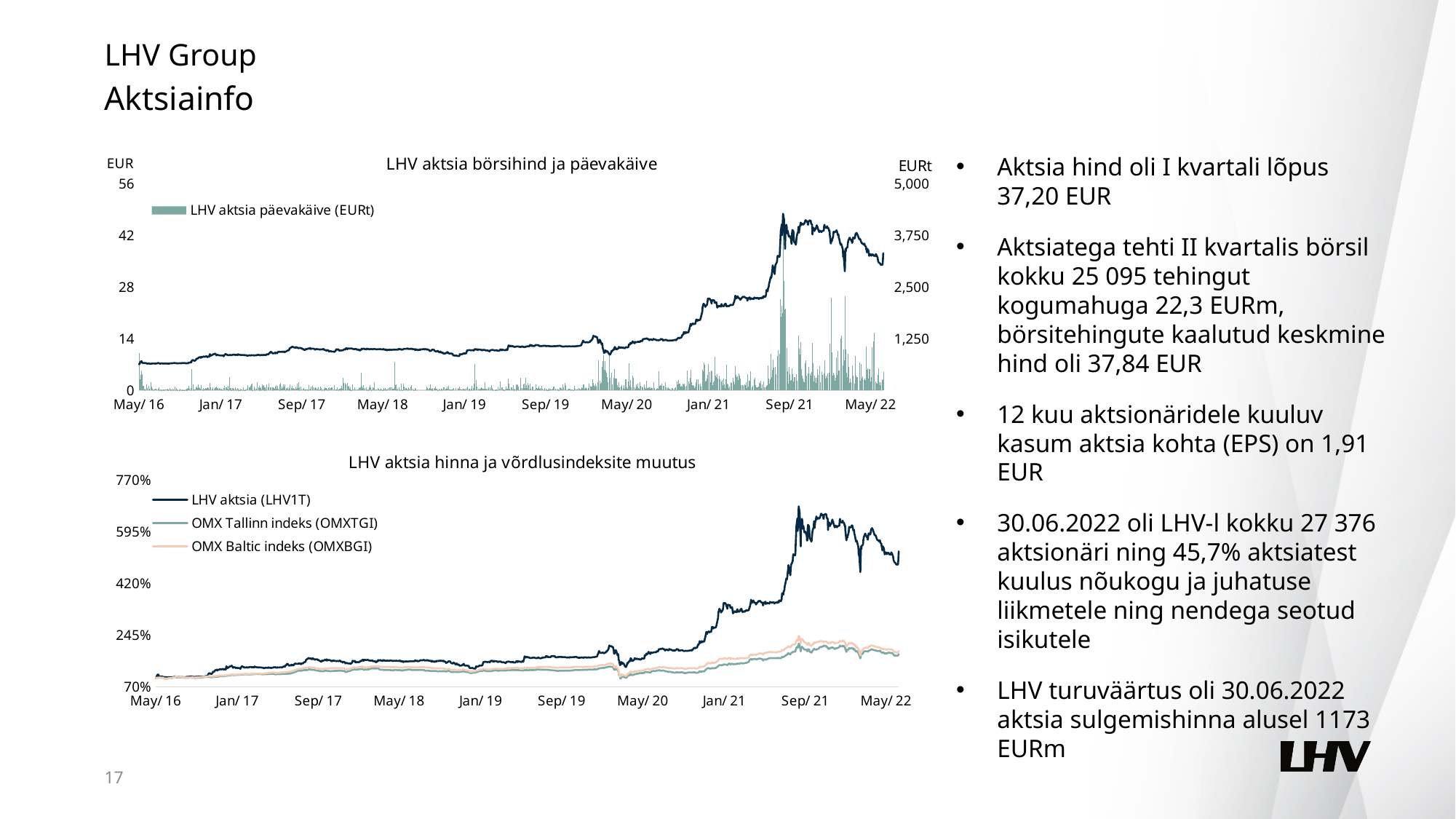
What kind of chart is the bottom chart, 'LHV aktsia hinna ja võrdlusindeksite muutus'? line chart In the bottom chart 'LHV aktsia hinna ja võrdlusindeksite muutus', which series is highest at May/22? LHV aktsia (LHV1T) In the bottom chart 'LHV aktsia hinna ja võrdlusindeksite muutus', is the value of LHV aktsia (LHV1T) at May/22 greater or less than 420%? greater What is the title of the top chart? LHV aktsia börsihind ja päevakäive In the top chart 'LHV aktsia börsihind ja päevakäive', does the share price line overall rise or fall from May/16 to May/22? rise In the top chart 'LHV aktsia börsihind ja päevakäive', is the share price (EUR) at May/22 greater or less than 28? greater In the bottom chart 'LHV aktsia hinna ja võrdlusindeksite muutus', is the value of OMX Tallinn indeks (OMXTGI) at May/22 greater or less than 245%? less What is the unit label on the right-hand axis of the top chart 'LHV aktsia börsihind ja päevakäive'? EURt How many series does the legend of the bottom chart 'LHV aktsia hinna ja võrdlusindeksite muutus' list? 3 In the bottom chart 'LHV aktsia hinna ja võrdlusindeksite muutus', does the LHV aktsia (LHV1T) line overall rise or fall from May/16 to May/22? rise In the bottom chart 'LHV aktsia hinna ja võrdlusindeksite muutus', which is larger at May/22: LHV aktsia (LHV1T) or OMX Baltic indeks (OMXBGI)? LHV aktsia (LHV1T)